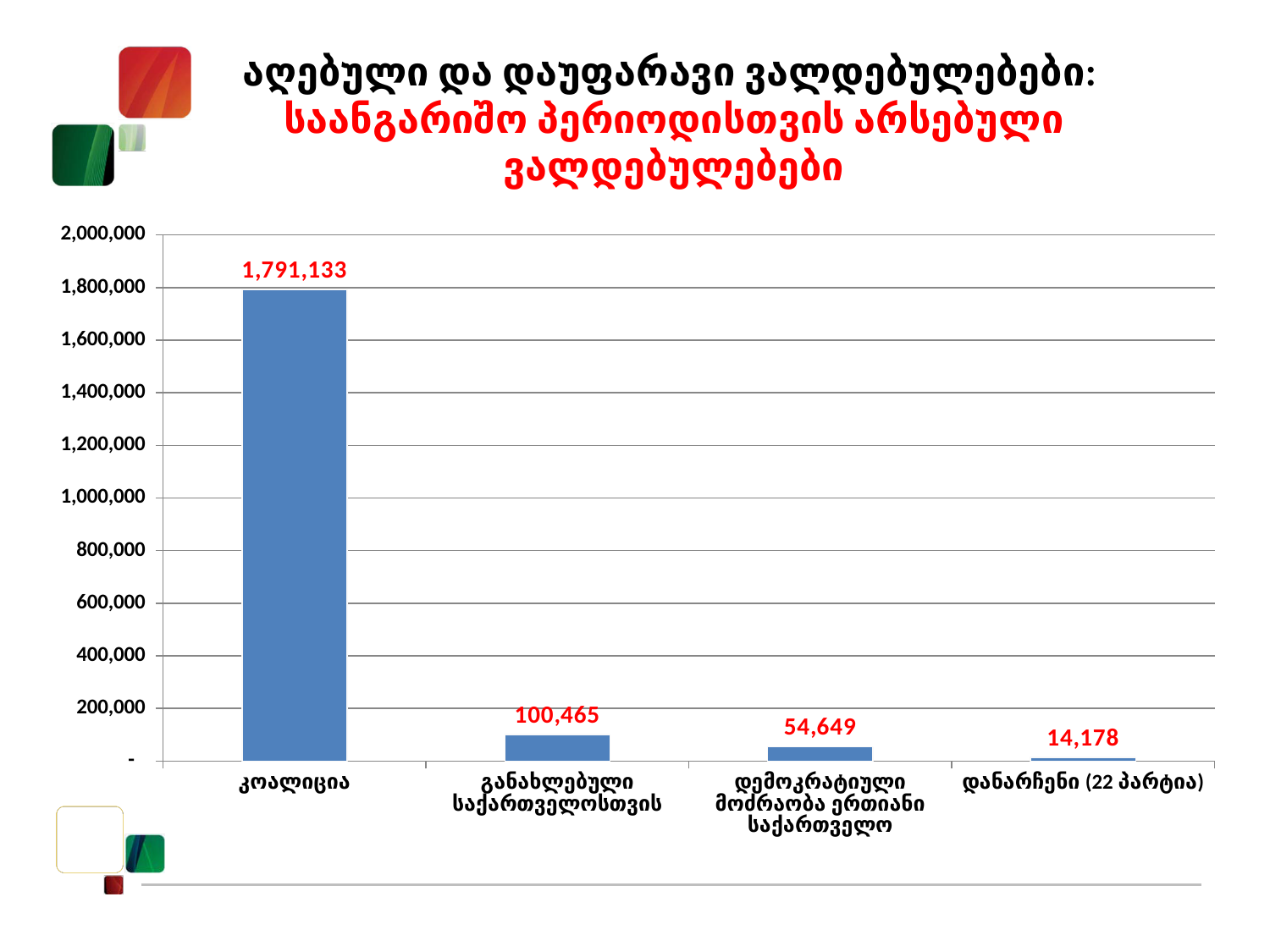
What is the value for დემოკრატიული მოძრაობა ერთიანი საქართველო? 54,649 What is the value for კოალიცია? 1,791,133 What is the value for განახლებული საქართველოსთვის? 100,465 What is the difference between the values for კოალიცია and განახლებული საქართველოსთვის? 1,690,668 What is the value for დანარჩენი (22 პარტია)? 14,178 Which category has the lowest value? დანარჩენი (22 პარტია) How many categories are shown on the x axis? 4 What is the difference between the values for დემოკრატიული მოძრაობა ერთიანი საქართველო and დანარჩენი (22 პარტია)? 40,471 What kind of chart is shown on the slide? bar chart Which is larger, the value for განახლებული საქართველოსთვის or the value for დემოკრატიული მოძრაობა ერთიანი საქართველო? განახლებული საქართველოსთვის Is the value for კოალიცია greater or less than 1,600,000? greater Which category has the highest value? კოალიცია